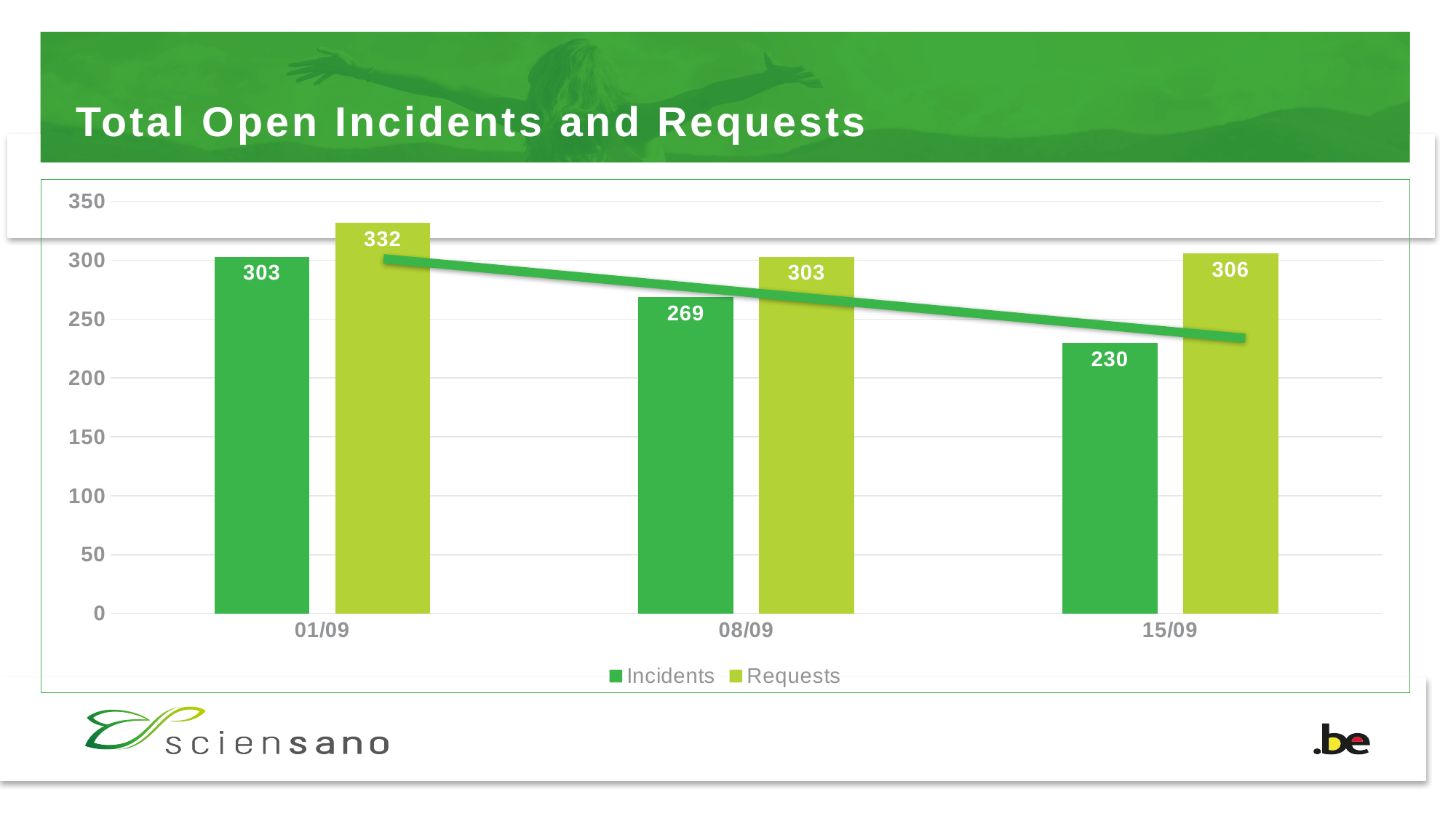
What is the difference between Incidents on 01/09 and Incidents on 15/09? 73 Which is larger on 08/09, Incidents or Requests? Requests On which date is the Requests value highest? 01/09 On which date is the Incidents value lowest? 15/09 How many series does the legend list? 2 What is the value for Incidents on 08/09? 269 Do the Incidents values rise or fall from 01/09 to 15/09? Fall What is the value for Requests on 15/09? 306 What kind of chart is shown on the slide? Bar chart What is the value for Incidents on 01/09? 303 How many dates are shown on the x axis? 3 What is the difference between Requests and Incidents on 15/09? 76